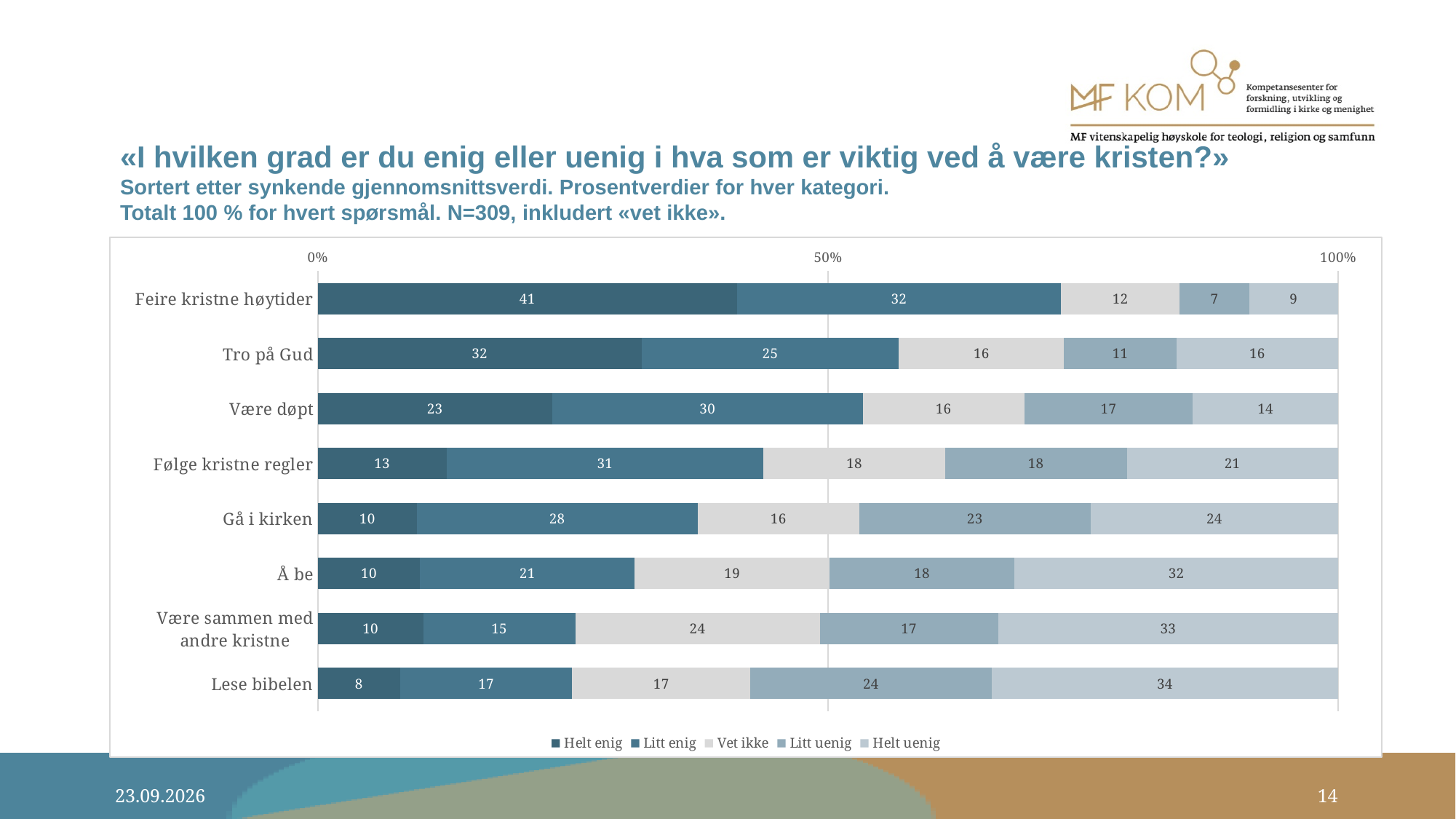
Which category has the lowest 'Helt enig' value? Lese bibelen Which legend entry is listed first in the chart legend? Helt enig What is the 'Helt enig' value for 'Feire kristne høytider'? 41 What is the 'Helt uenig' value for 'Lese bibelen'? 34 What kind of chart is shown on the slide? Stacked bar chart How many categories (statements) are plotted on the chart? 8 What is the difference between the 'Helt uenig' values for 'Å be' and 'Feire kristne høytider'? 23 How many series does the legend list? 5 Which category has the highest 'Helt enig' value? Feire kristne høytider Which is larger: the 'Litt uenig' value for 'Gå i kirken' or for 'Å be'? Gå i kirken What is the 'Vet ikke' value for 'Være sammen med andre kristne'? 24 What is the difference between the 'Helt enig' values for 'Tro på Gud' and 'Være døpt'? 9